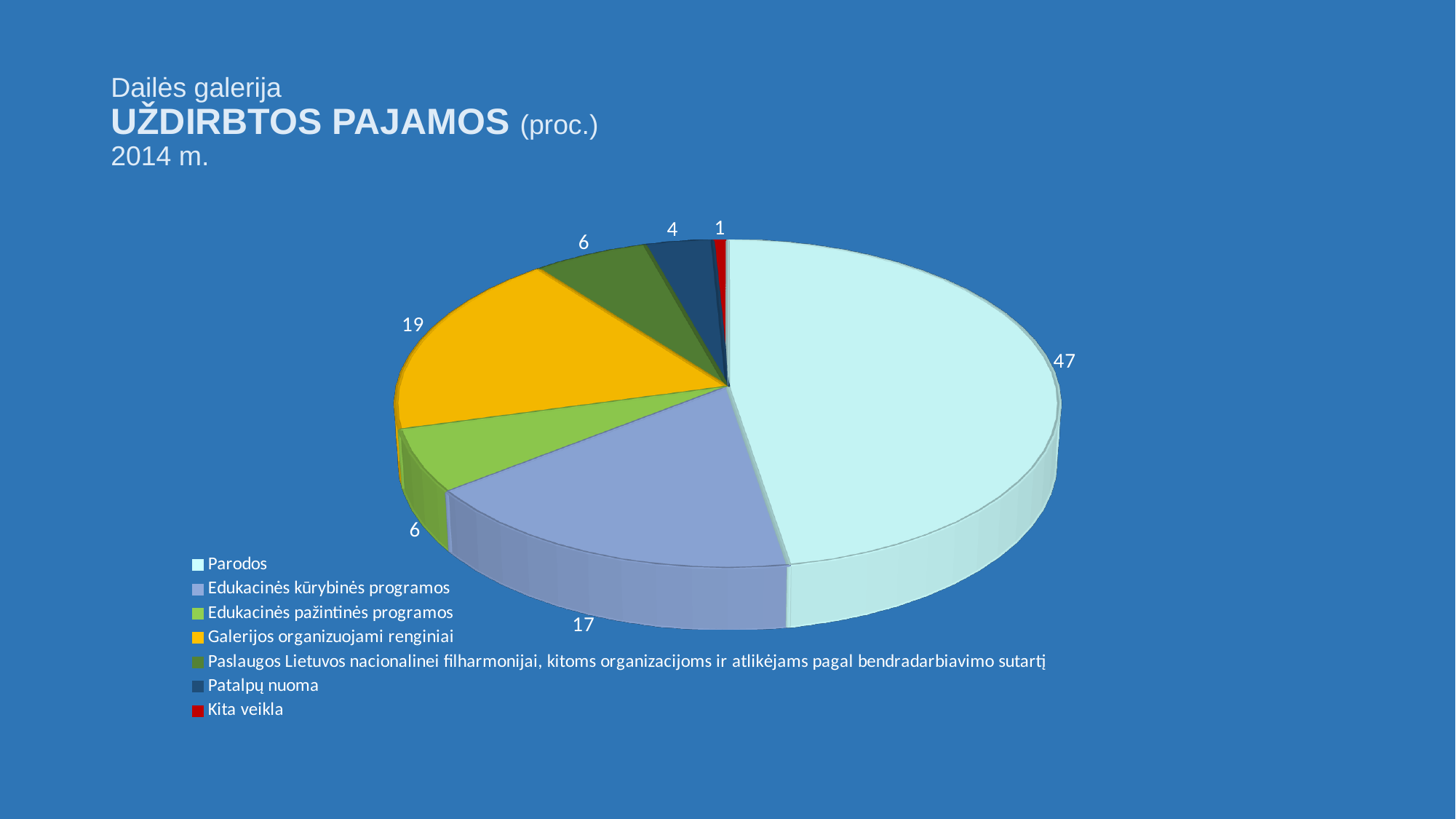
What is the value for Patalpų nuoma? 4 Which category has the smallest slice? Kita veikla Which category has the largest slice? Parodos What type of chart is shown on the slide? pie chart What is the value for Parodos? 47 What is the value for Kita veikla? 1 Which year does the chart title refer to? 2014 m. What is the difference between the values for Parodos and Galerijos organizuojami renginiai? 28 What is the value for Edukacinės kūrybinės programos? 17 How many categories does the pie chart have? 7 Which is larger, Galerijos organizuojami renginiai or Edukacinės kūrybinės programos? Galerijos organizuojami renginiai What is the value for Galerijos organizuojami renginiai? 19